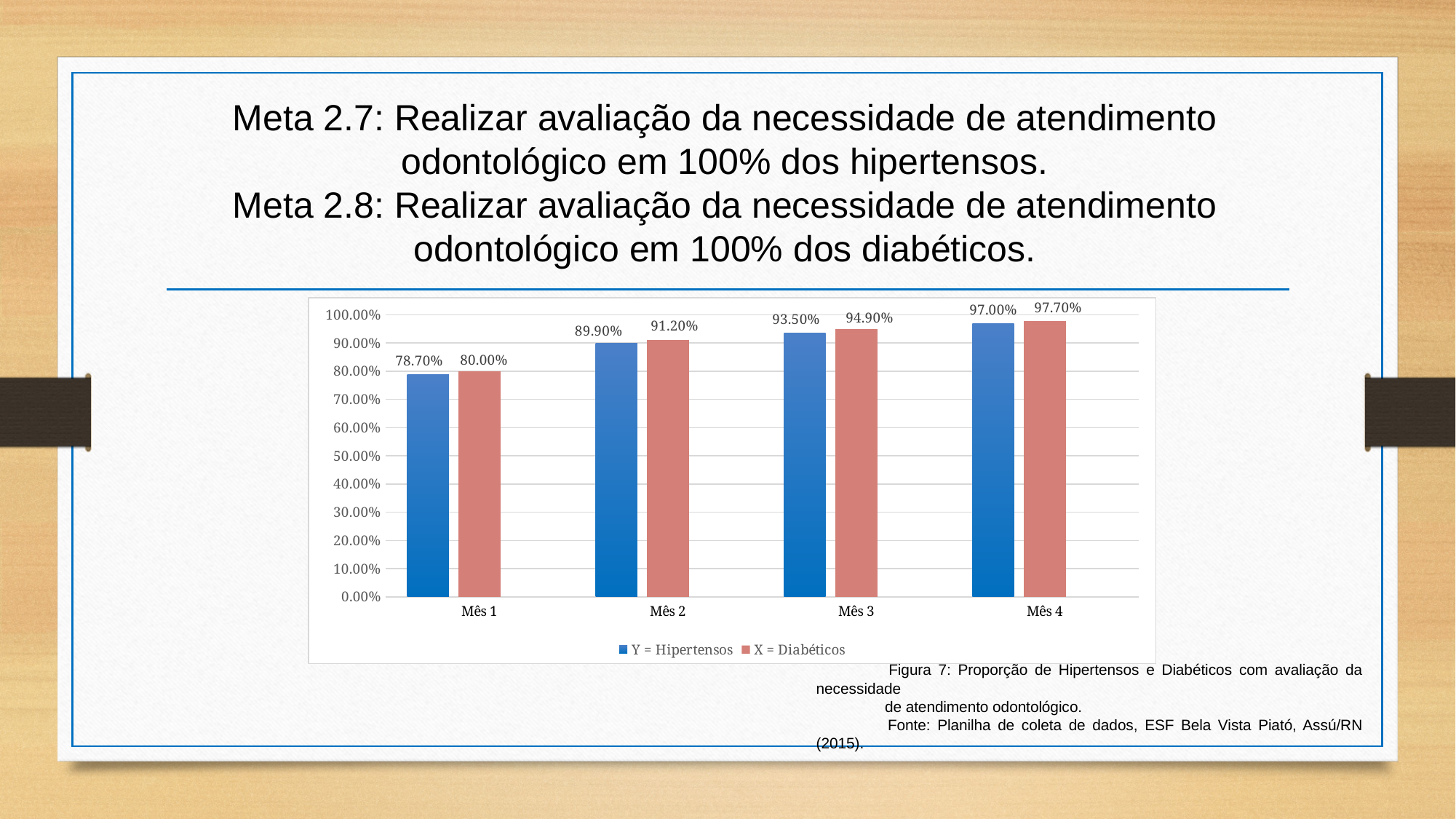
How many months are shown on the x axis? 4 In which month is the value for Y = Hipertensos lowest? Mês 1 What is the value for X = Diabéticos in Mês 3? 94.90% What is the difference between X = Diabéticos and Y = Hipertensos in Mês 2? 1.30% What kind of chart is shown on the slide? Bar chart What is the value for Y = Hipertensos in Mês 1? 78.70% Do the values for Y = Hipertensos rise or fall from Mês 1 to Mês 4? Rise How many series does the legend list? 2 What colour are the bars for X = Diabéticos? Red What is the value for Y = Hipertensos in Mês 4? 97.00% Which is larger in Mês 1: Y = Hipertensos or X = Diabéticos? X = Diabéticos In which month is the value for X = Diabéticos highest? Mês 4